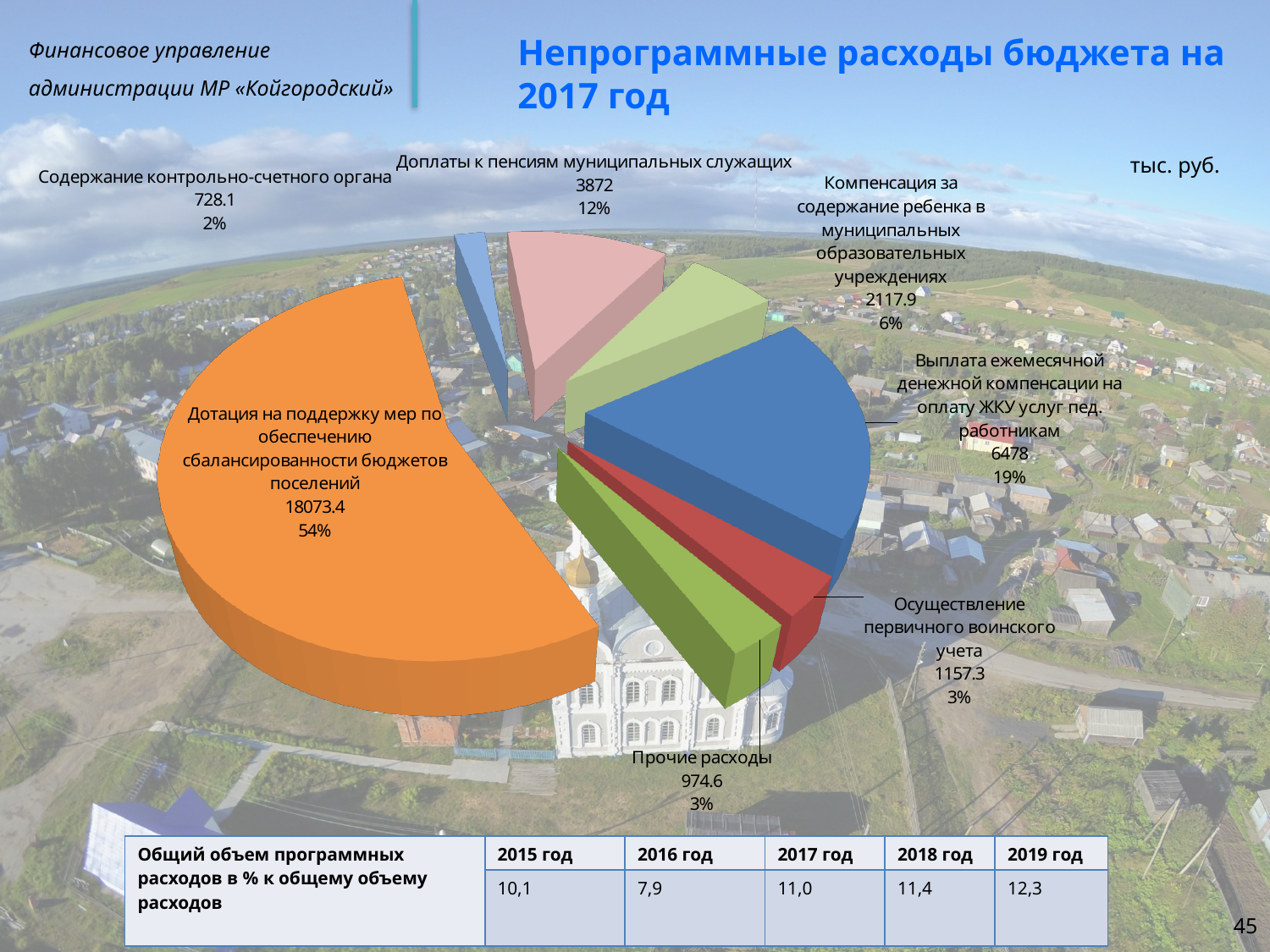
What is the value for «Дотация на поддержку мер по обеспечению сбалансированности бюджетов поселений»? 18073.4 What is the difference between the values for «Выплата ежемесячной денежной компенсации на оплату ЖКУ услуг пед. работникам» and «Доплаты к пенсиям муниципальных служащих»? 2606 What is the value for «Осуществление первичного воинского учета»? 1157.3 Which category has the largest slice of the pie? Дотация на поддержку мер по обеспечению сбалансированности бюджетов поселений What is the title of the chart on the slide? Непрограммные расходы бюджета на 2017 год What share of the pie does «Выплата ежемесячной денежной компенсации на оплату ЖКУ услуг пед. работникам» represent? 19% What type of chart is shown on the slide? pie chart What share of the pie does «Содержание контрольно-счетного органа» represent? 2% What is the value for «Доплаты к пенсиям муниципальных служащих»? 3872 Which category has the smallest slice of the pie? Содержание контрольно-счетного органа Which is larger: the value for «Компенсация за содержание ребенка в муниципальных образовательных учреждениях» or for «Прочие расходы»? Компенсация за содержание ребенка в муниципальных образовательных учреждениях How many slices does the pie chart have? 7